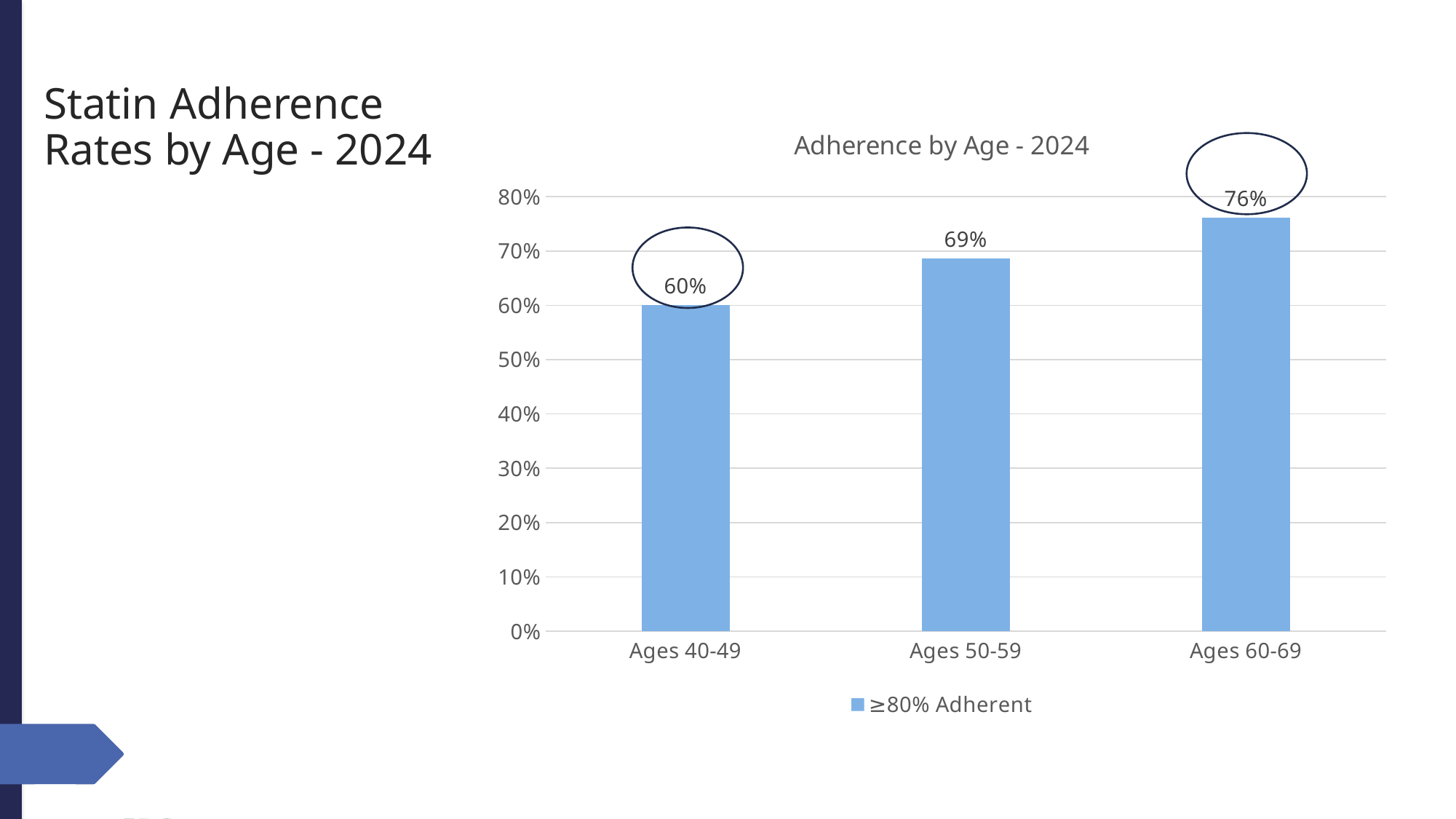
Which age group has the lowest adherence rate? Ages 40-49 What is the difference between the values for Ages 60-69 and Ages 40-49? 16% Do the values rise or fall from Ages 40-49 to Ages 60-69? Rise Is the value for Ages 50-59 greater or less than 70%? less Which age group has the highest adherence rate? Ages 60-69 What is the value for Ages 60-69? 76% What is the difference between the values for Ages 50-59 and Ages 40-49? 9% What is the value for Ages 50-59? 69% What is the value for Ages 40-49? 60% How many age groups are shown on the chart? 3 What kind of chart is shown on the slide? Bar chart Which is larger, the value for Ages 50-59 or Ages 60-69? Ages 60-69